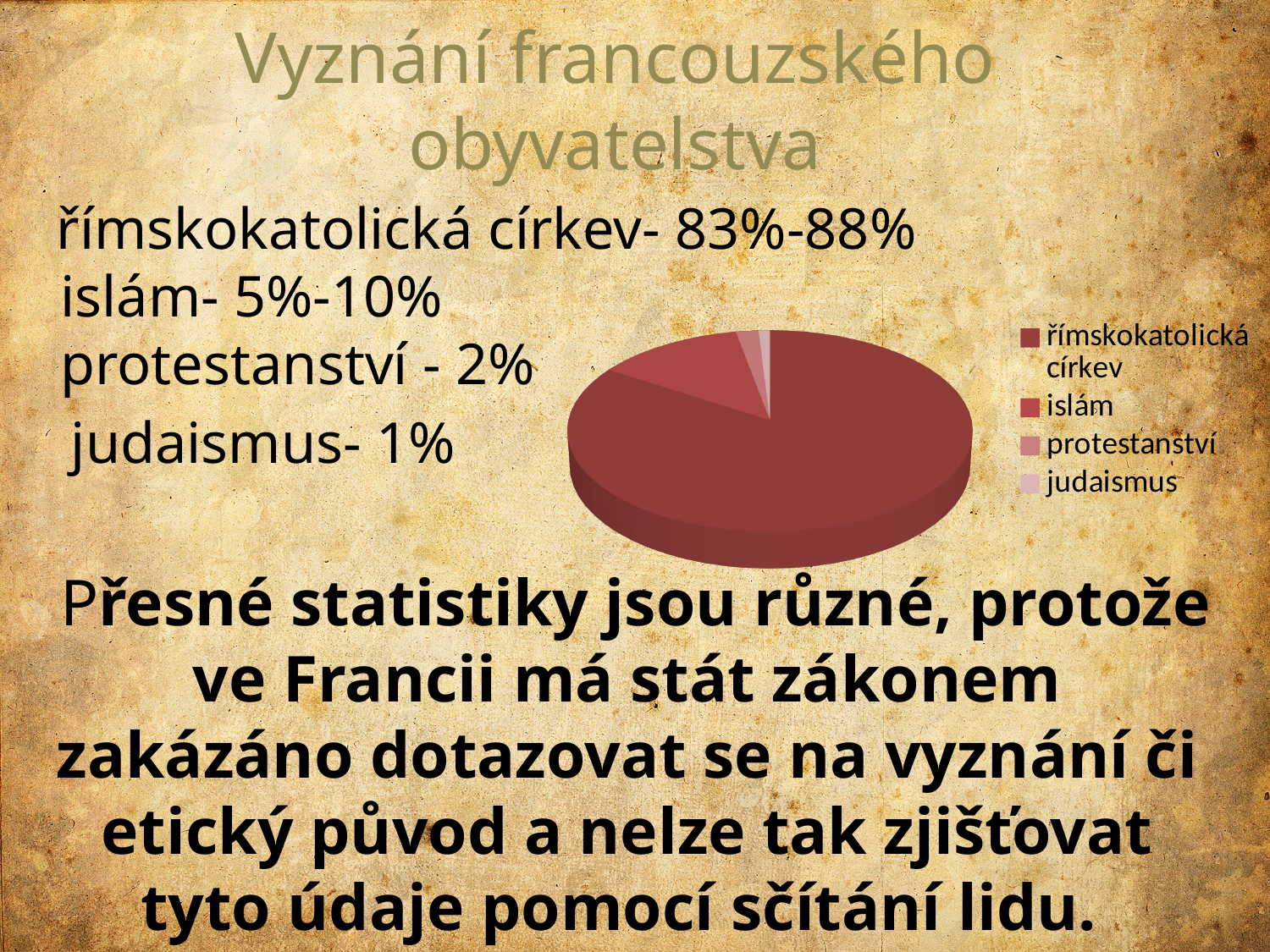
Which category has the smallest slice in the pie chart? judaismus How many entries does the chart legend list? 4 Which legend entry is listed first in the pie chart's legend? římskokatolická církev Which slice is larger in the pie chart, protestanství or judaismus? protestanství Which slice is larger in the pie chart, islám or protestanství? islám Which slice is larger in the pie chart, římskokatolická církev or islám? římskokatolická církev What kind of chart is shown on the slide? pie chart Which category has the second-largest slice in the pie chart? islám What is the title of the slide containing the pie chart? Vyznání francouzského obyvatelstva How many slices does the pie chart have? 4 Which category has the largest slice in the pie chart? římskokatolická církev